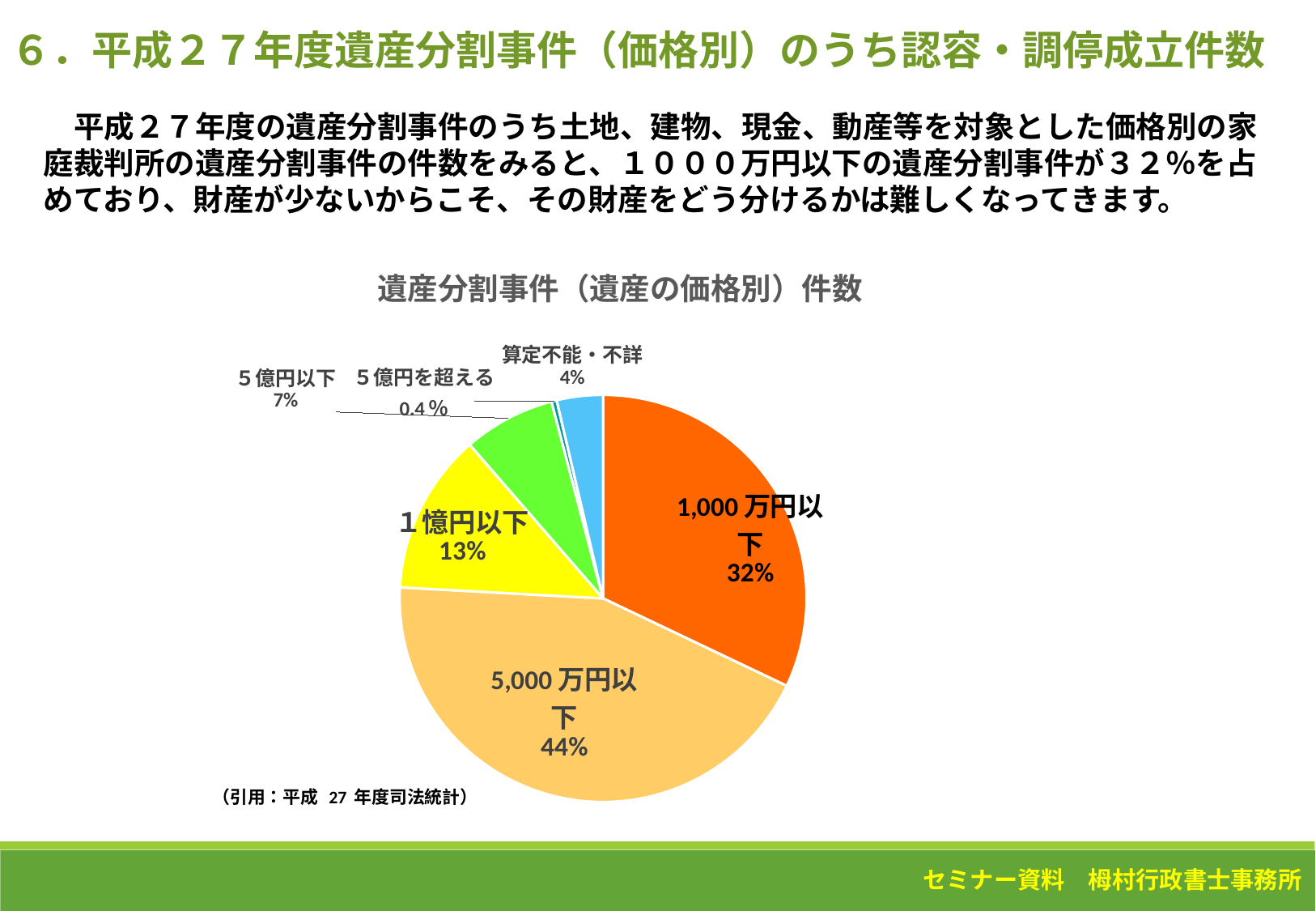
How many slices does the pie chart have? 6 What is the value shown for 算定不能・不詳? 4% What is the title of the chart? 遺産分割事件（遺産の価格別）件数 What is the value shown for 5億円以下? 7% Which category has the smallest slice of the pie? 5億円を超える What is the value shown for 1億円以下? 13% What kind of chart is shown on the slide? pie chart What share of the pie does 5,000万円以下 account for? 44% Which category has the largest slice of the pie? 5,000万円以下 What is the difference between the shares of 5,000万円以下 and 1,000万円以下? 12% What is the value shown for 5億円を超える? 0.4％ What share of the pie does 1,000万円以下 account for? 32%